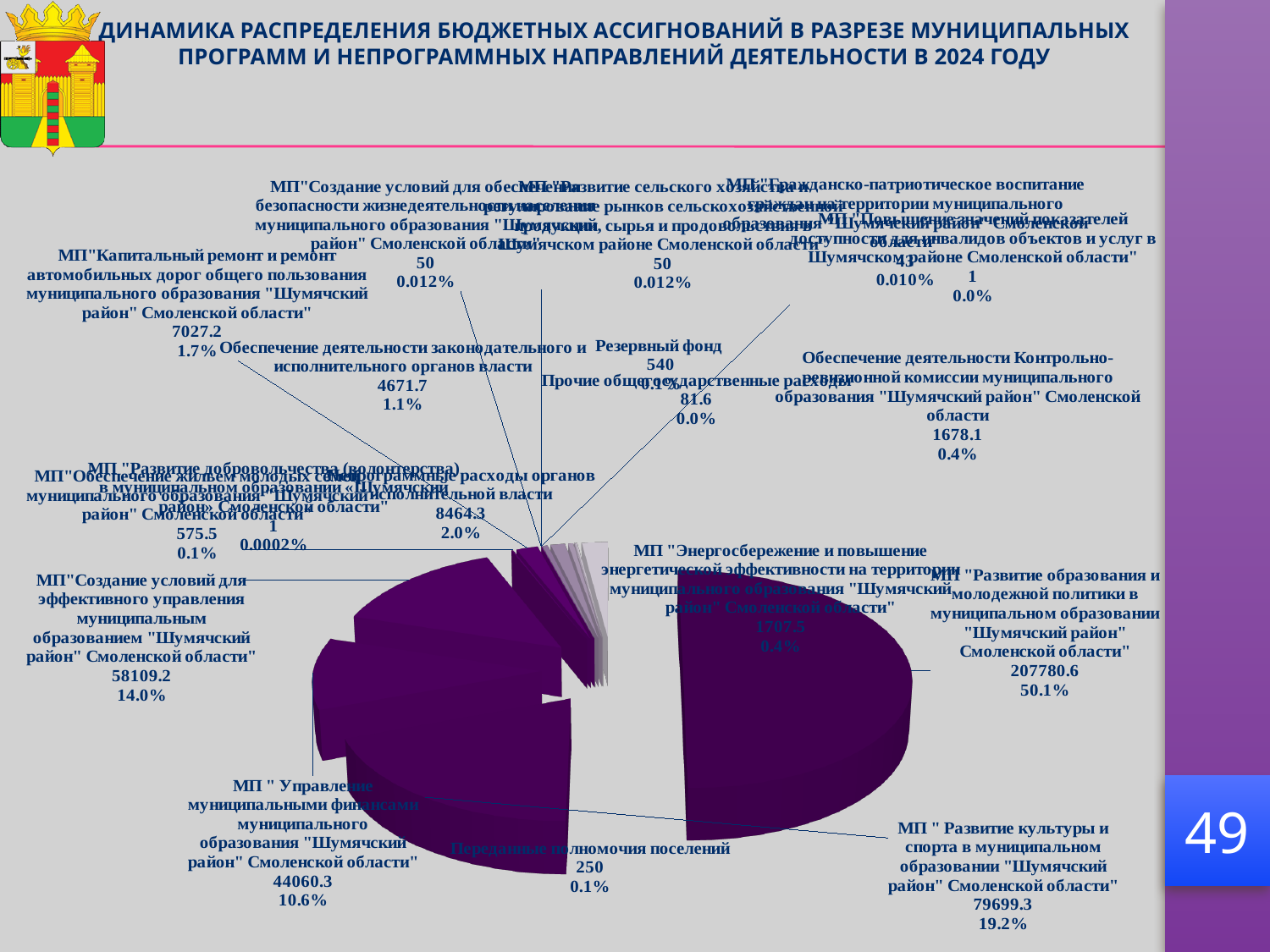
What is the difference between the values for МП "Развитие образования и молодежной политики" and МП "Развитие культуры и спорта"? 128081.3 What share of the pie does МП "Управление муниципальными финансами муниципального образования "Шумячский район" Смоленской области" account for? 10.6% What is the value for Резервный фонд? 540 What is the value for МП "Развитие образования и молодежной политики в муниципальном образовании "Шумячский район" Смоленской области"? 207780.6 What is the value for МП "Развитие культуры и спорта в муниципальном образовании "Шумячский район" Смоленской области"? 79699.3 What is the value for Обеспечение деятельности Контрольно-ревизионной комиссии муниципального образования "Шумячский район" Смоленской области? 1678.1 Which category has the largest slice of the pie? МП "Развитие образования и молодежной политики в муниципальном образовании "Шумячский район" Смоленской области" What kind of chart is shown on the slide? pie chart Which is larger: the value for МП "Развитие культуры и спорта" or the value for МП "Управление муниципальными финансами"? МП "Развитие культуры и спорта" What is the value for МП "Создание условий для эффективного управления муниципальным образованием "Шумячский район" Смоленской области"? 58109.2 What is the value for Передаваемые полномочия поселений? 250 What share of the pie does МП "Развитие образования и молодежной политики" account for? 50.1%